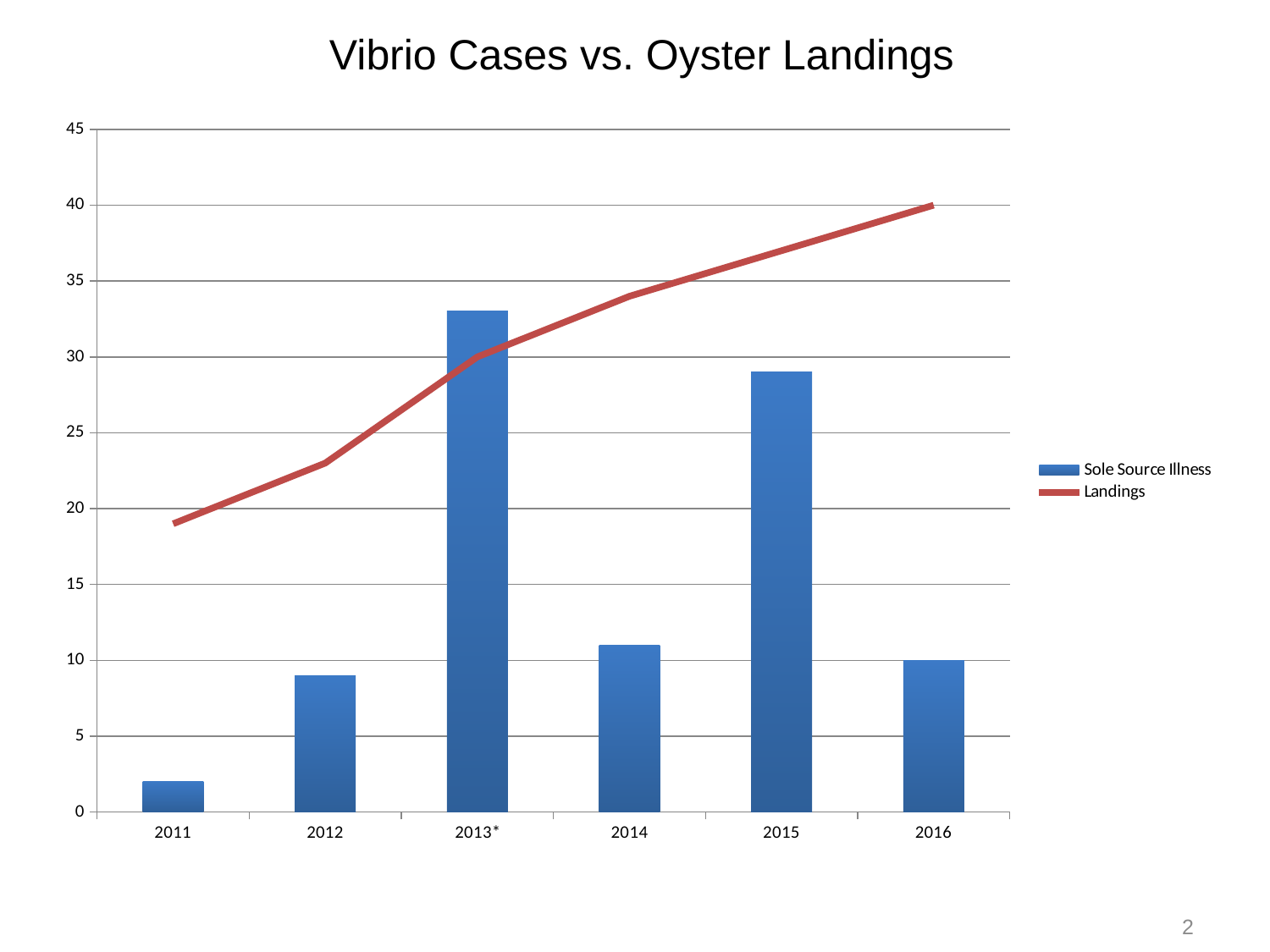
Which year has the lowest Sole Source Illness bar? 2011 Is the Landings value for 2011 greater or less than 20? less What are the two series named in the legend? Sole Source Illness and Landings What is the Sole Source Illness value for 2016? 10 Is the Sole Source Illness value for 2015 greater or less than 25? greater Which year has the larger Sole Source Illness value, 2012 or 2014? 2014 What kind of chart is shown on the slide? A bar chart combined with a line chart Do the Landings values rise or fall from 2011 to 2016? Rise How many years are shown on the x axis? 6 Is the Sole Source Illness value for 2013* greater or less than 30? greater Which year has the highest Sole Source Illness bar? 2013* How many series does the legend list? 2